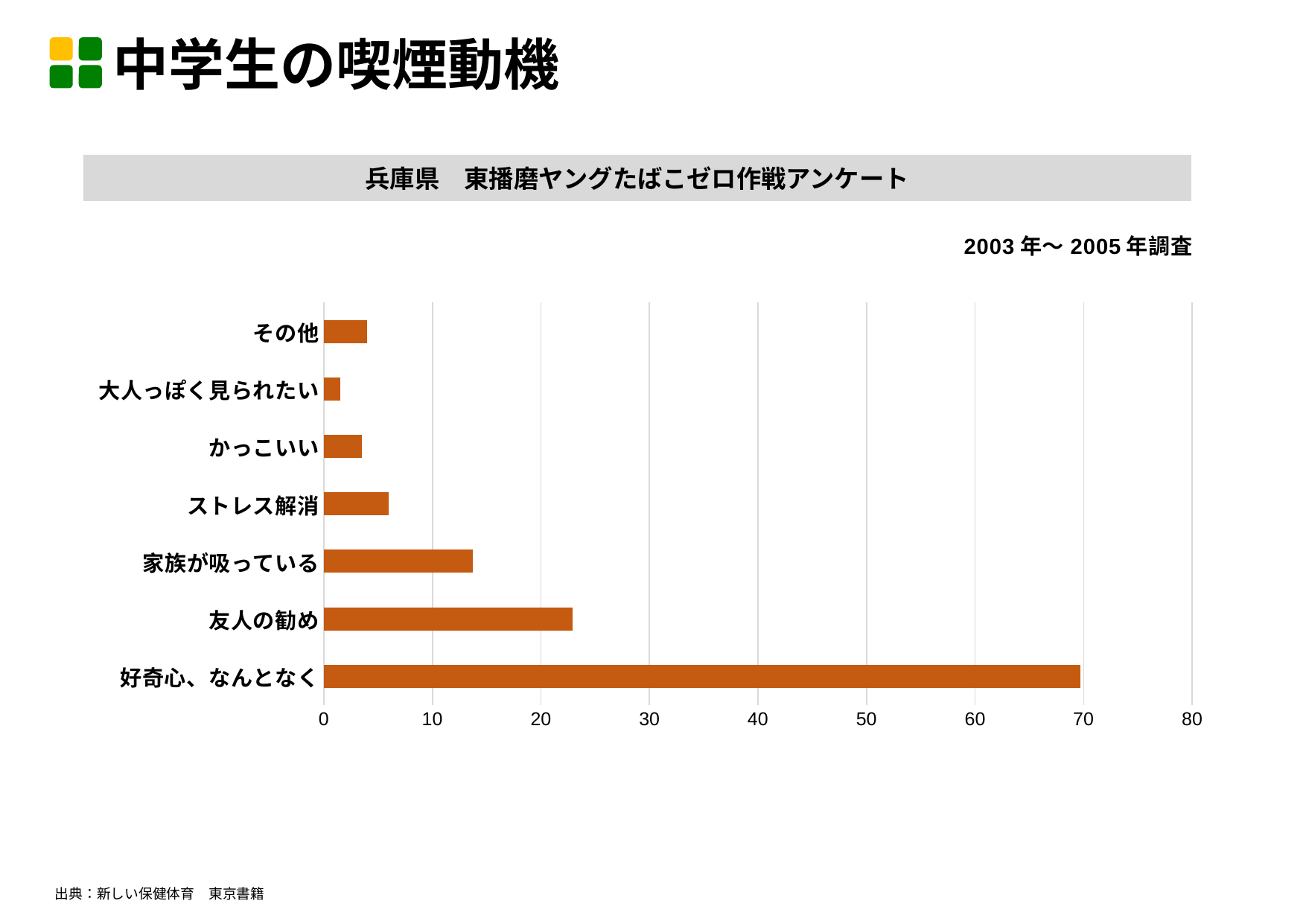
What is the title of the survey shown above the chart? 兵庫県 東播磨ヤングたばこゼロ作戦アンケート What kind of chart is shown on the slide? bar chart What survey period is stated on the slide? 2003年〜2005年調査 Is the value for 好奇心、なんとなく greater or less than 60? greater Is the value for 友人の勧め greater or less than 30? less Is the value for その他 greater or less than 10? less How many categories (smoking motives) are plotted in the chart? 7 Which category has the lowest value in the chart? 大人っぽく見られたい Which is larger, the value for 友人の勧め or the value for 家族が吸っている? 友人の勧め Which is larger, the value for ストレス解消 or the value for かっこいい? ストレス解消 Which category has the highest value in the chart? 好奇心、なんとなく